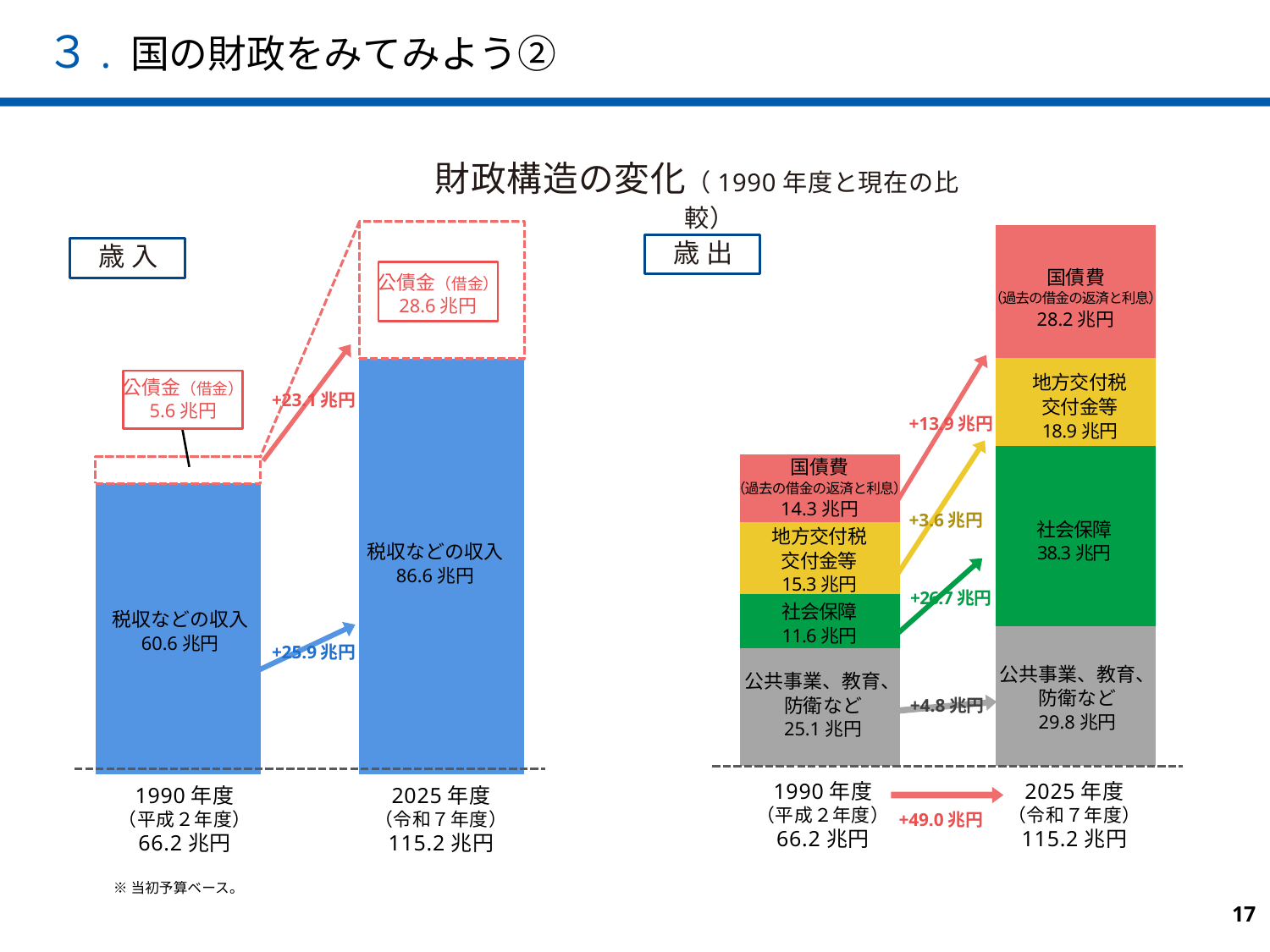
歳出のグラフは何種類の項目に分かれていますか？ 4 歳入のグラフで、2025年度の税収などの収入はいくらですか？ 86.6兆円 歳出のグラフで、2025年度の社会保障はいくらですか？ 38.3兆円 歳出のグラフで、1990年度から2025年度にかけて社会保障はいくら増えましたか？ +26.7兆円 歳入のグラフで、1990年度から2025年度にかけて公債金（借金）はいくら増えましたか？ +23.1兆円 歳入のグラフで、2025年度の歳入合計はいくらですか？ 115.2兆円 歳出のグラフで、1990年度に最も小さい項目はどれですか？ 社会保障 歳出のグラフで、2025年度の国債費と地方交付税交付金等ではどちらが大きいですか？ 国債費 歳出のグラフで、1990年度に最も大きい項目はどれですか？ 公共事業、教育、防衛など 歳入のグラフで、1990年度の公債金（借金）はいくらですか？ 5.6兆円 歳出のグラフで、1990年度の地方交付税交付金等はいくらですか？ 15.3兆円 歳出のグラフで、1990年度の歳出合計はいくらですか？ 66.2兆円